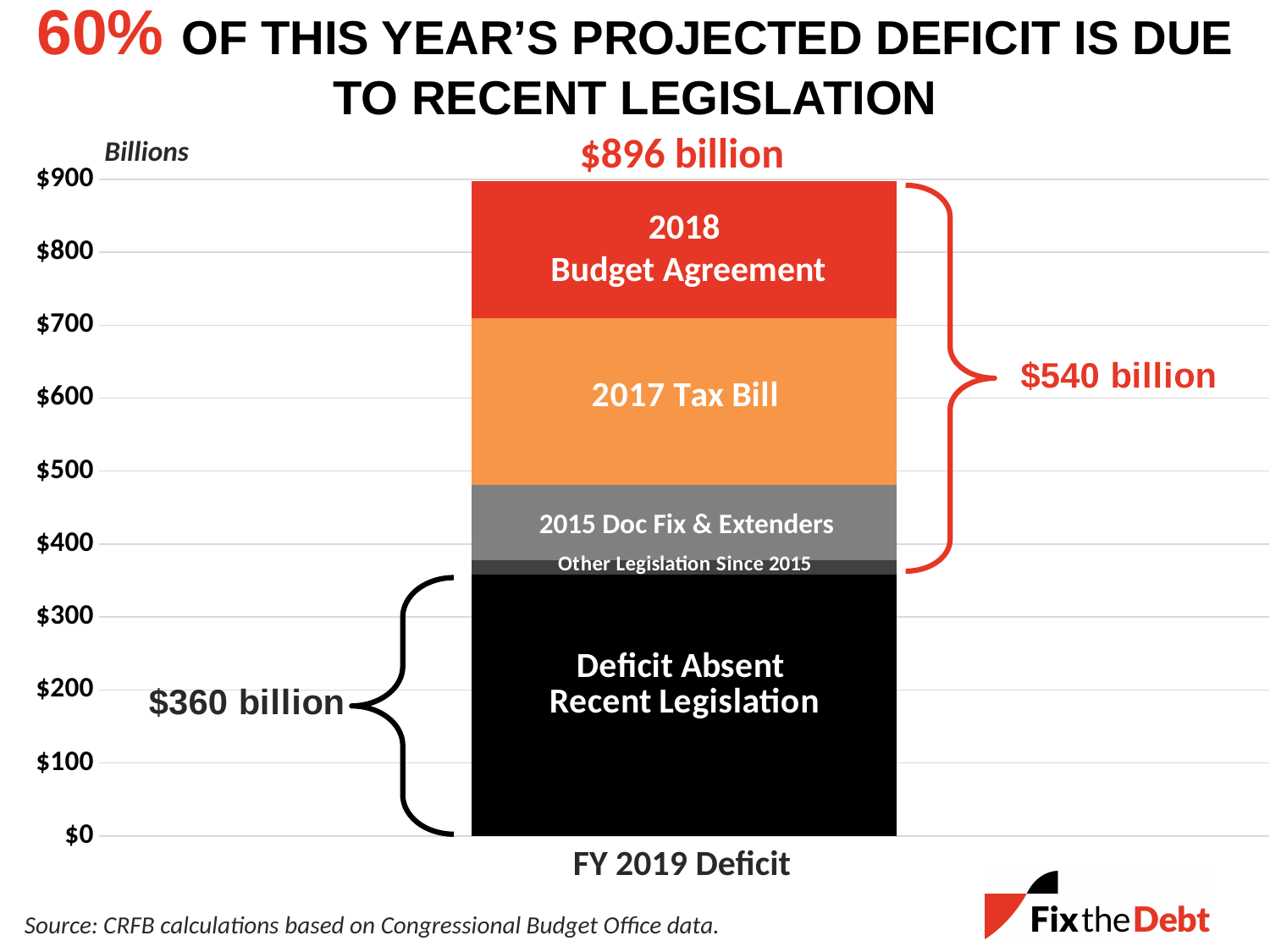
How much larger is the $540 billion due to recent legislation than the $360 billion deficit absent recent legislation? $180 billion What is the category label shown beneath the bar on the x axis? FY 2019 Deficit Which segment is larger, 2017 Tax Bill or 2015 Doc Fix & Extenders? 2017 Tax Bill What combined value is given for the segments attributed to recent legislation (2018 Budget Agreement, 2017 Tax Bill, 2015 Doc Fix & Extenders, and Other Legislation Since 2015)? $540 billion Which segment of the stacked bar is the largest? Deficit Absent Recent Legislation Is the total height of the bar greater or less than $800 billion? greater How many segments make up the stacked bar? 5 Which segment of the stacked bar is the smallest? Other Legislation Since 2015 What is the total FY 2019 deficit shown at the top of the stacked bar? $896 billion What value is given for the Deficit Absent Recent Legislation segment? $360 billion What kind of chart is shown on the slide? Stacked bar chart According to the slide, what share of this year's projected deficit is due to recent legislation? 60%